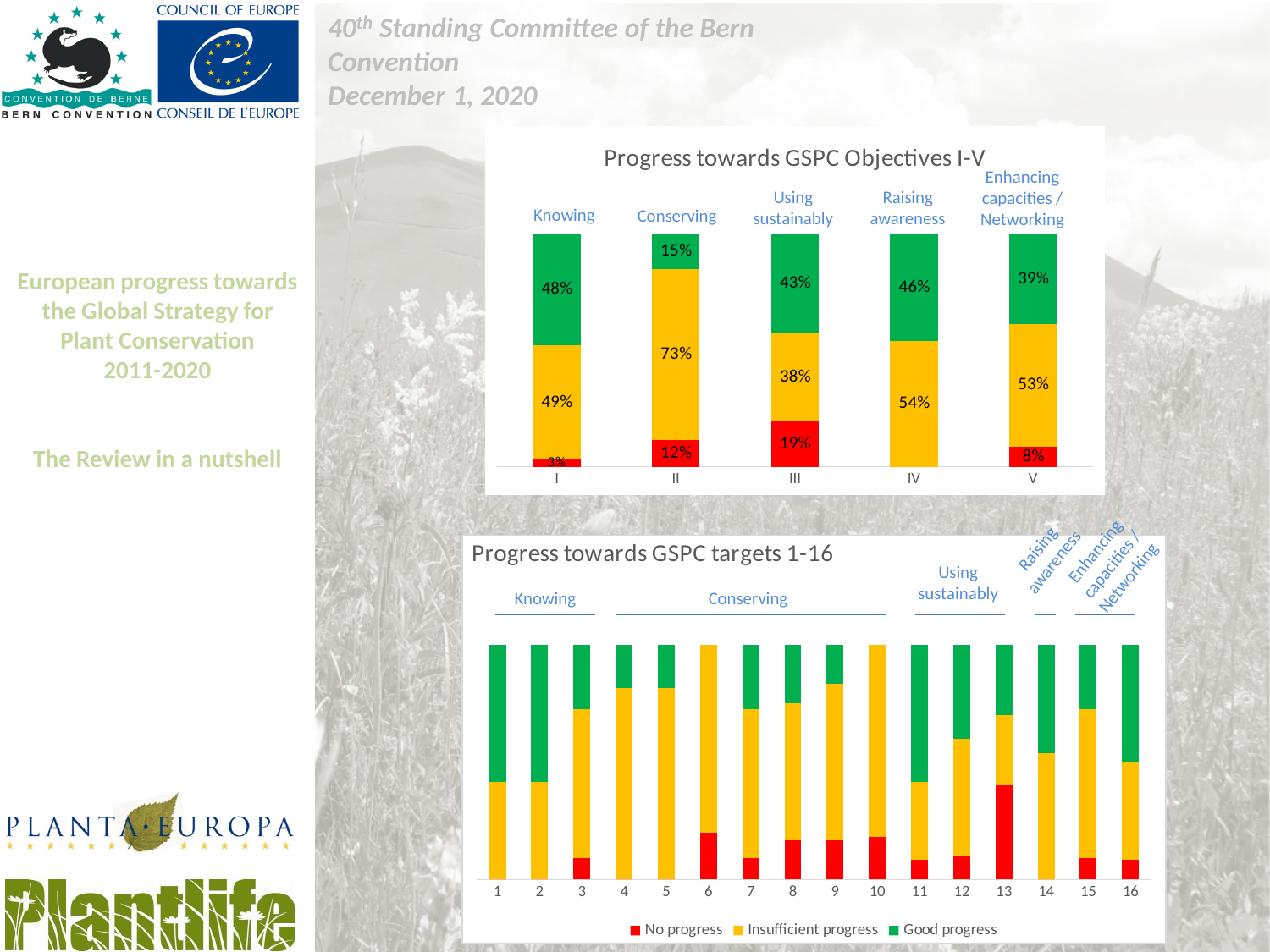
In the 'Progress towards GSPC Objectives I-V' chart, is the green value for Objective III larger or smaller than the green value for Objective IV? smaller In the 'Progress towards GSPC Objectives I-V' chart, what is the green (good progress) value for Objective I (Knowing)? 48% In the 'Progress towards GSPC Objectives I-V' chart, which objective has the lowest green (good progress) value? II (Conserving) In the 'Progress towards GSPC Objectives I-V' chart, what is the difference between the yellow value for Objective II and the yellow value for Objective I? 24 percentage points How many series does the legend of the 'Progress towards GSPC targets 1-16' chart list? 3 In the 'Progress towards GSPC Objectives I-V' chart, which objective has the largest red (no progress) segment? III (Using sustainably) In the 'Progress towards GSPC Objectives I-V' chart, what is the red (no progress) value for Objective III (Using sustainably)? 19% In the 'Progress towards GSPC Objectives I-V' chart, what is the yellow (insufficient progress) value for Objective II (Conserving)? 73% How many targets (bars) are shown in the 'Progress towards GSPC targets 1-16' chart? 16 In the 'Progress towards GSPC Objectives I-V' chart, which objective has the highest green (good progress) value? I (Knowing) In the 'Progress towards GSPC Objectives I-V' chart, what is the yellow value for Objective V (Enhancing capacities / Networking)? 53% How many objectives (bars) are shown in the 'Progress towards GSPC Objectives I-V' chart? 5